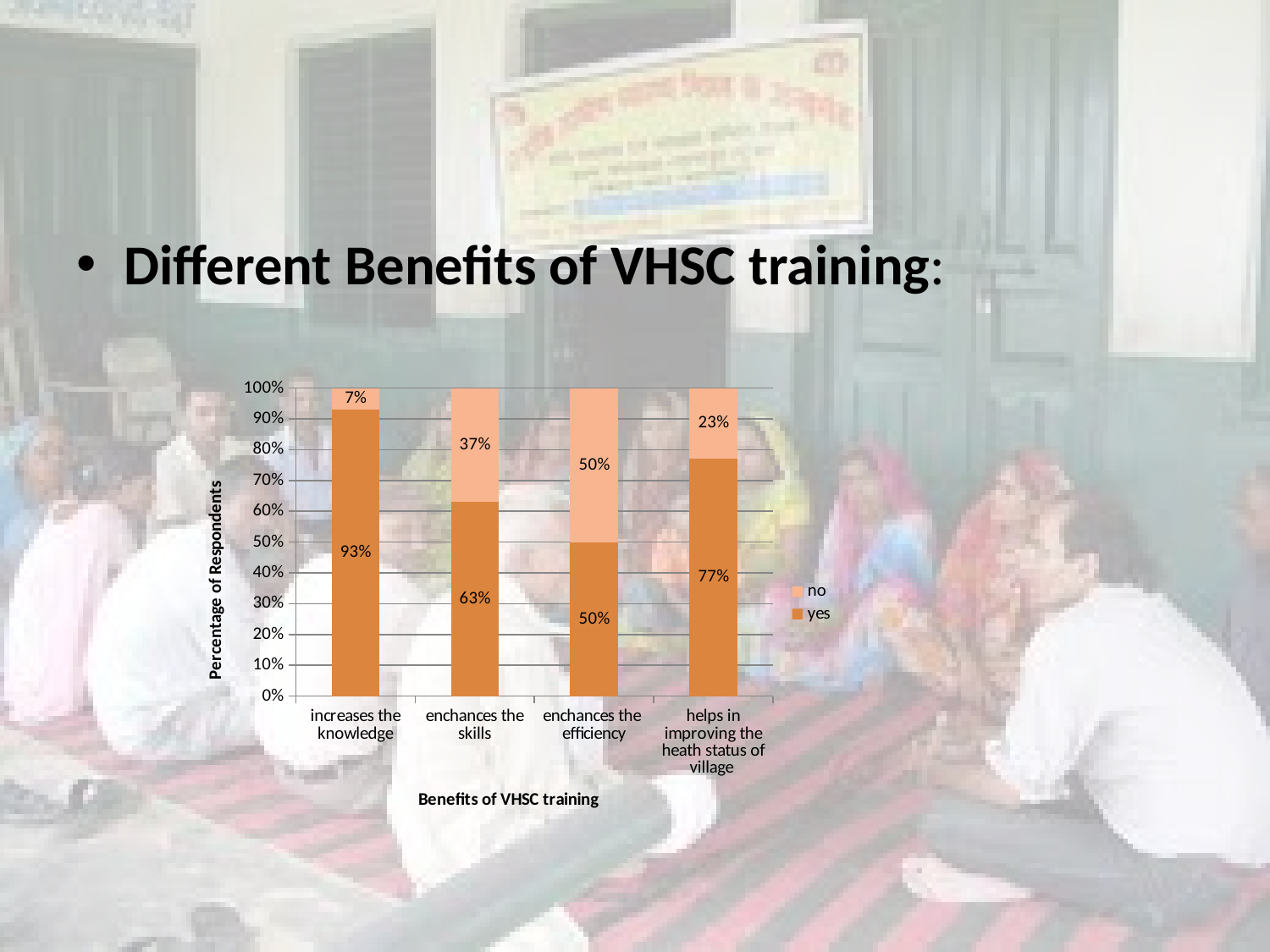
Which benefit has the lowest 'yes' percentage? enchances the efficiency Which benefit has the highest 'yes' percentage? increases the knowledge What is the label of the y axis? Percentage of Respondents What kind of chart is shown on the slide? stacked bar chart What percentage of respondents said 'yes' for 'increases the knowledge'? 93% What percentage of respondents said 'no' for 'enchances the skills'? 37% How many benefit categories are shown on the x axis? 4 What is the 'yes' value for 'helps in improving the heath status of village'? 77% Which is larger: the 'no' value for 'enchances the skills' or the 'no' value for 'helps in improving the heath status of village'? enchances the skills How many series does the legend list? 2 What is the difference between the 'yes' values for 'increases the knowledge' and 'enchances the skills'? 30% What is the 'no' value for 'enchances the efficiency'? 50%